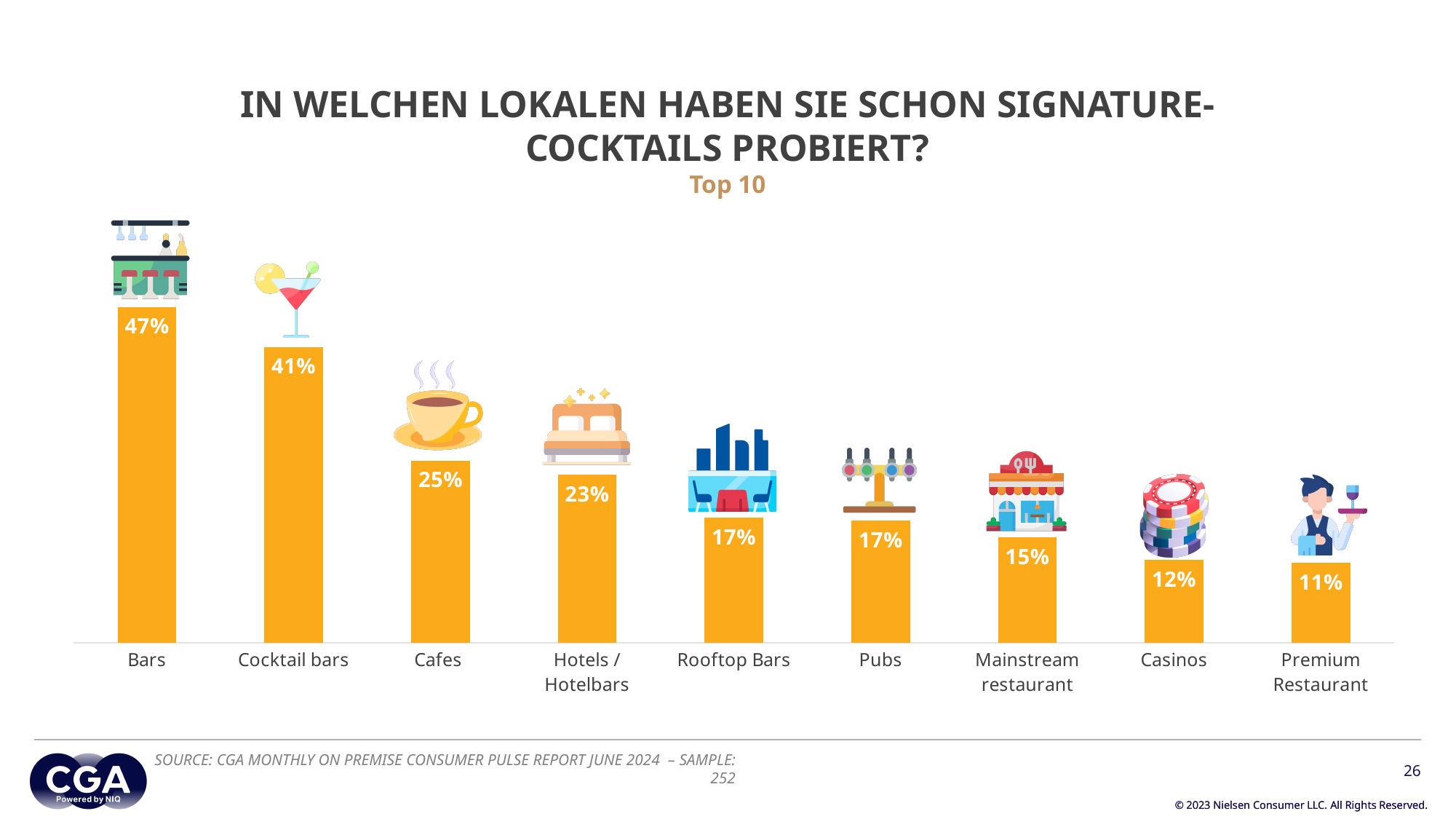
What percentage is shown for Casinos? 12% How many categories are shown in the chart? 9 What percentage is shown for Cocktail bars? 41% What kind of chart is shown on the slide? Bar chart Which has a larger value, Cafes or Pubs? Cafes What is the difference between the values for Cafes and Mainstream restaurant? 10% Which category has the highest value? Bars What percentage is shown for Hotels / Hotelbars? 23% What is the difference between the values for Bars and Cocktail bars? 6% What percentage is shown for Bars? 47% Which category has the lowest value? Premium Restaurant Do the values rise or fall from left to right along the x axis? Fall